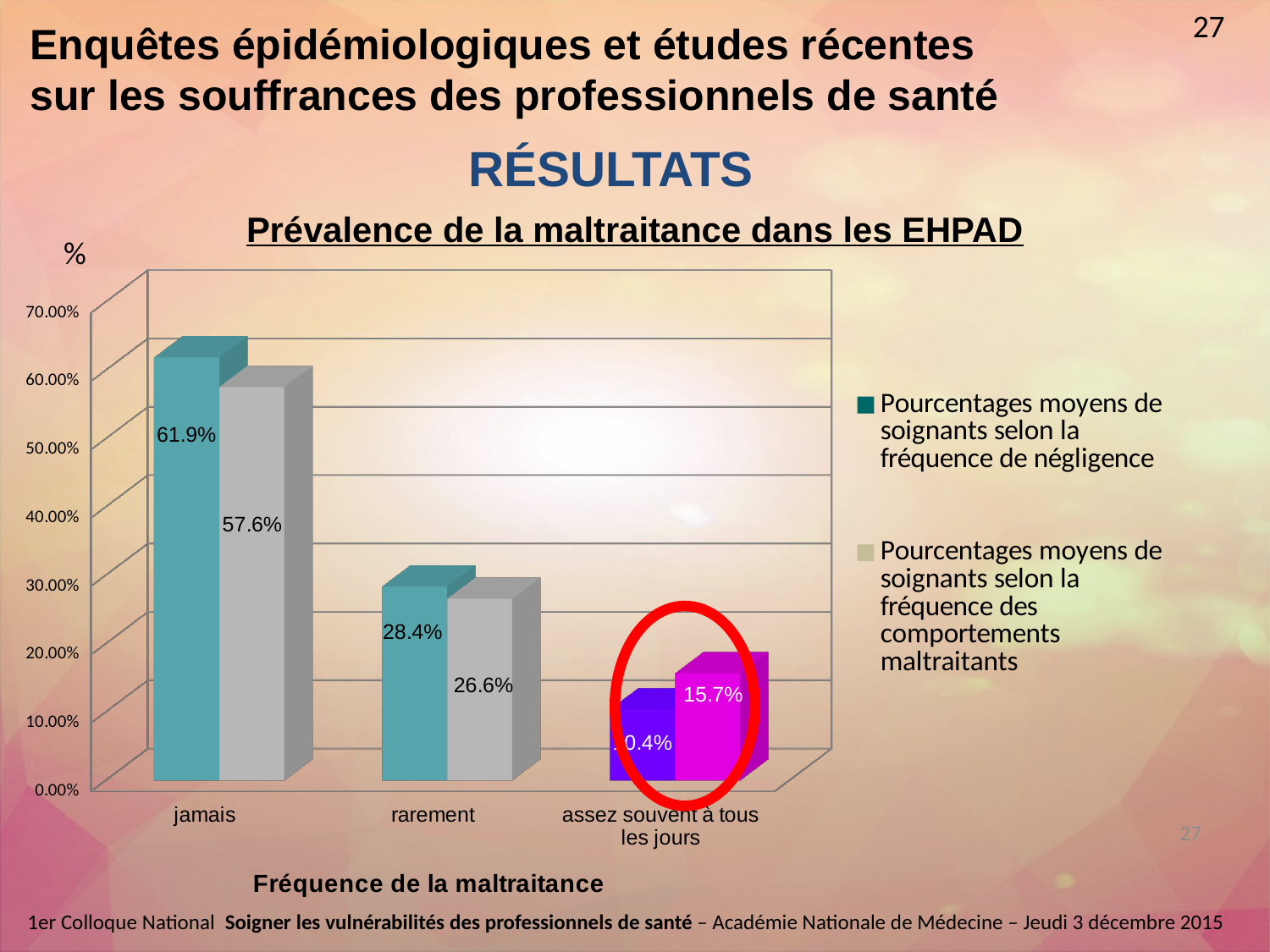
Which category has the highest value in the series 'Pourcentages moyens de soignants selon la fréquence de négligence'? jamais What is the value for 'jamais' in the series 'Pourcentages moyens de soignants selon la fréquence de négligence'? 61.9% What is the value for 'rarement' in the series 'Pourcentages moyens de soignants selon la fréquence de négligence'? 28.4% What is the value for 'rarement' in the series 'Pourcentages moyens de soignants selon la fréquence des comportements maltraitants'? 26.6% What is the title of the chart? Prévalence de la maltraitance dans les EHPAD How many series does the legend list? 2 What is the difference between the 'jamais' values of the two series? 4.3% Which is larger for 'rarement': the négligence series value or the comportements maltraitants series value? the négligence series value (28.4%) What is the value for 'assez souvent à tous les jours' in the series 'Pourcentages moyens de soignants selon la fréquence des comportements maltraitants'? 15.7% What type of chart is shown on the slide? bar chart How many categories are shown on the x axis? 3 What is the value for 'jamais' in the series 'Pourcentages moyens de soignants selon la fréquence des comportements maltraitants'? 57.6%